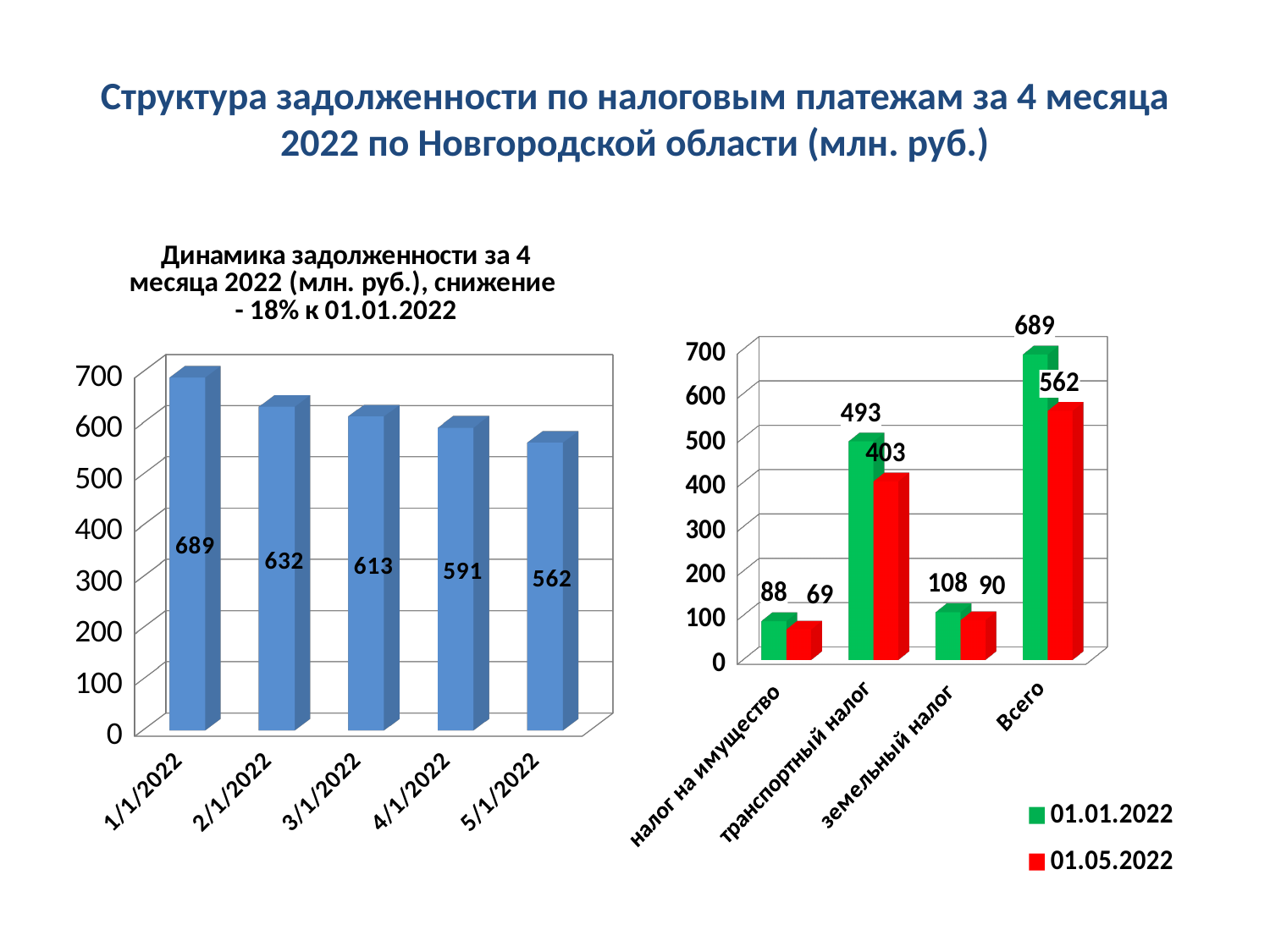
In the left chart (Динамика задолженности за 4 месяца 2022), do the values rise or fall from 1/1/2022 to 5/1/2022? fall In the left chart (Динамика задолженности за 4 месяца 2022), how many dates are plotted? 5 In the left chart (Динамика задолженности за 4 месяца 2022), which date has the lowest value? 5/1/2022 In the left chart (Динамика задолженности за 4 месяца 2022), what is the value for 1/1/2022? 689 In the right chart, what is the difference between the 01.01.2022 and 01.05.2022 values for транспортный налог? 90 In the right chart, what is the value for земельный налог on 01.01.2022? 108 In the right chart, which category has the lowest value for 01.05.2022? налог на имущество In the left chart (Динамика задолженности за 4 месяца 2022), what is the difference between the values for 1/1/2022 and 5/1/2022? 127 In the left chart (Динамика задолженности за 4 месяца 2022), what is the value for 5/1/2022? 562 What kind of chart is the right chart? bar chart In the right chart, what is the value for транспортный налог on 01.05.2022? 403 In the right chart, how many series does the legend list? 2